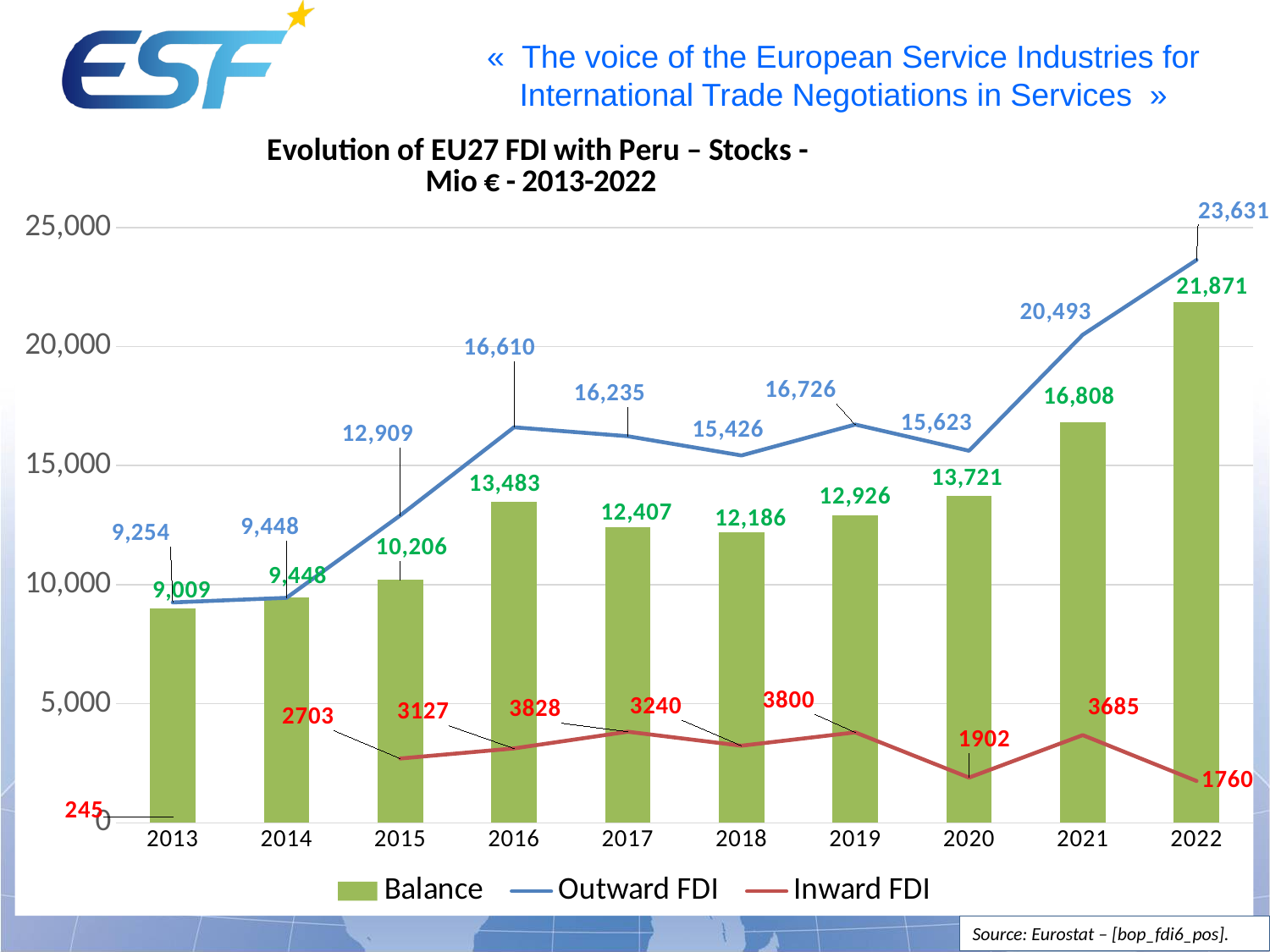
What is the difference between Outward FDI in 2022 and in 2021? 3,138 Is the Outward FDI value for 2019 greater or less than 15,000? greater What is the Outward FDI value for 2022? 23,631 What kind of chart is this? Combined bar and line chart How many series does the legend list? 3 What is the Inward FDI value for 2020? 1902 In which year is the Balance highest? 2022 Which year has the larger Balance, 2017 or 2018? 2017 How many years are shown on the x axis? 10 What is the Balance value for 2016? 13,483 In which year is Outward FDI lowest? 2013 Does Outward FDI rise or fall from 2020 to 2022? rise